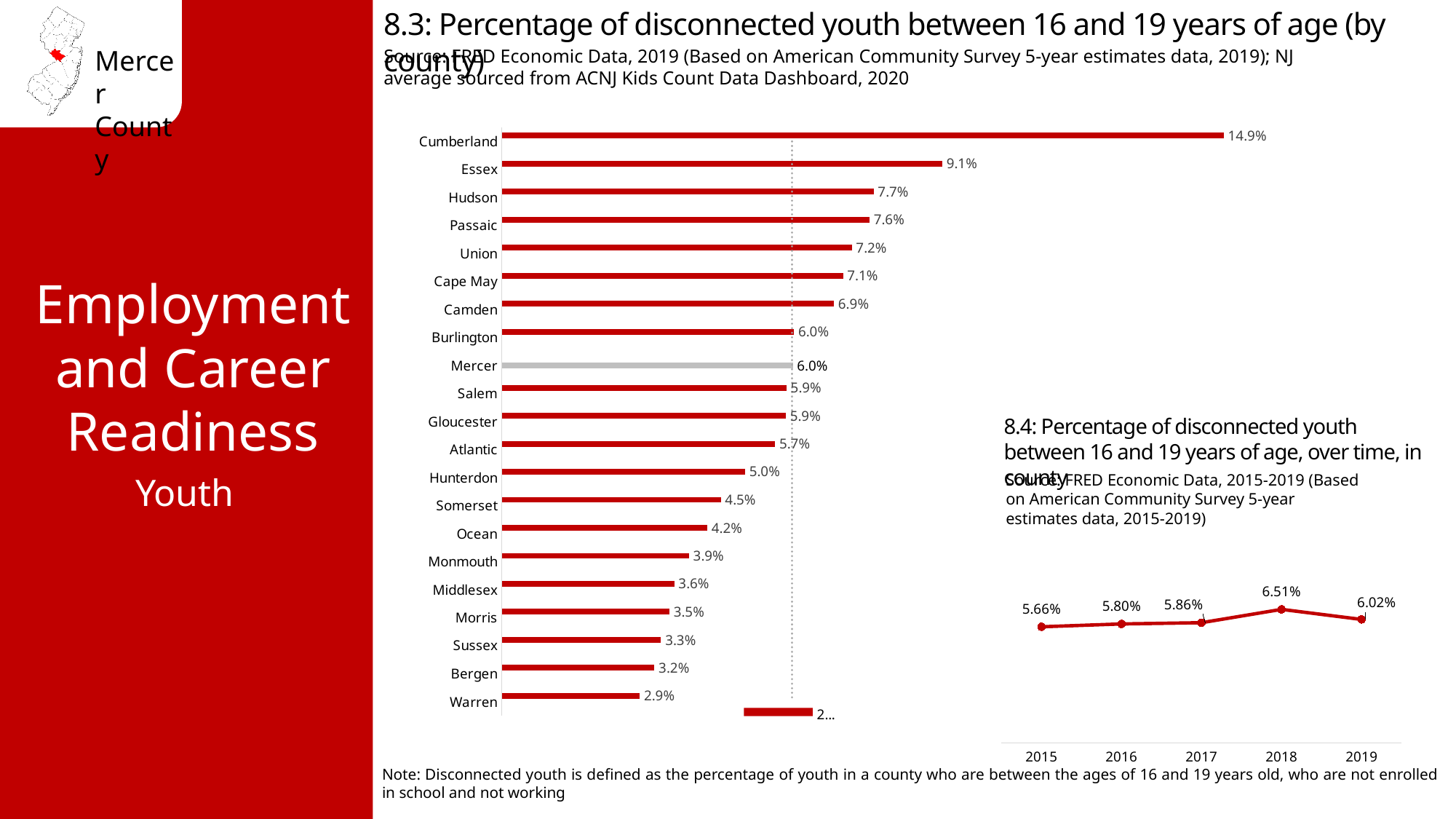
In the chart 8.3 (percentage of disconnected youth by county), which county has the lowest value? Warren In the chart 8.3 (percentage of disconnected youth by county), which county has the highest value? Cumberland How many counties are shown in the chart 8.3 (percentage of disconnected youth by county)? 21 In the chart 8.4 (percentage of disconnected youth over time), which year has the lowest value? 2015 In the chart 8.3 (percentage of disconnected youth by county), which is larger, the value for Somerset or the value for Ocean? Somerset What kind of chart is chart 8.4 (percentage of disconnected youth over time)? Line chart In the chart 8.4 (percentage of disconnected youth over time), what is the difference between the 2018 and 2019 values? 0.49% In the chart 8.3 (percentage of disconnected youth by county), what is the value for Hudson? 7.7% In the chart 8.3 (percentage of disconnected youth by county), what is the value for Mercer? 6.0% In the chart 8.4 (percentage of disconnected youth over time), what is the value for 2018? 6.51% What kind of chart is chart 8.3 (percentage of disconnected youth by county)? Bar chart In the chart 8.3 (percentage of disconnected youth by county), what is the difference between Cumberland and Essex? 5.8%